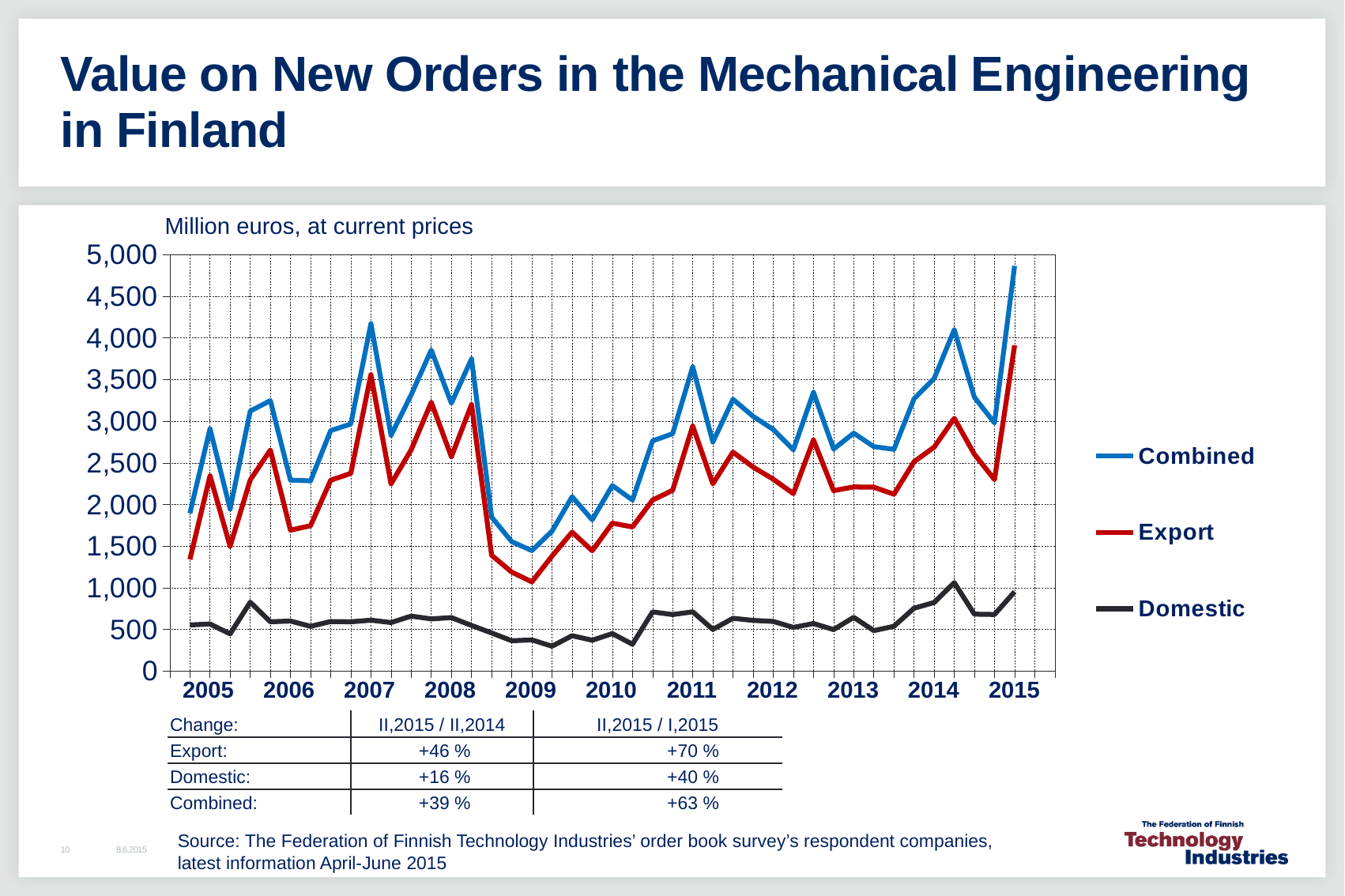
Is the value for Export larger or smaller than the value for Domestic at the end of 2015? larger Does the Combined series rise or fall between 2008 and 2009? fall Which series has the lowest values throughout the chart? Domestic What unit is stated above the chart for the values? Million euros, at current prices Which series are listed in the legend? Combined, Export, Domestic How many series does the legend list? 3 Is the value for Export at the last point in 2015 greater or less than 3,500? greater Which series has the highest values throughout the chart? Combined How many years are labelled on the x axis? 11 Is the value for Combined at the last point in 2015 greater or less than 4,500? greater What kind of chart is shown on the slide? line chart Is the lowest value for Combined in 2009 greater or less than 2,000? less